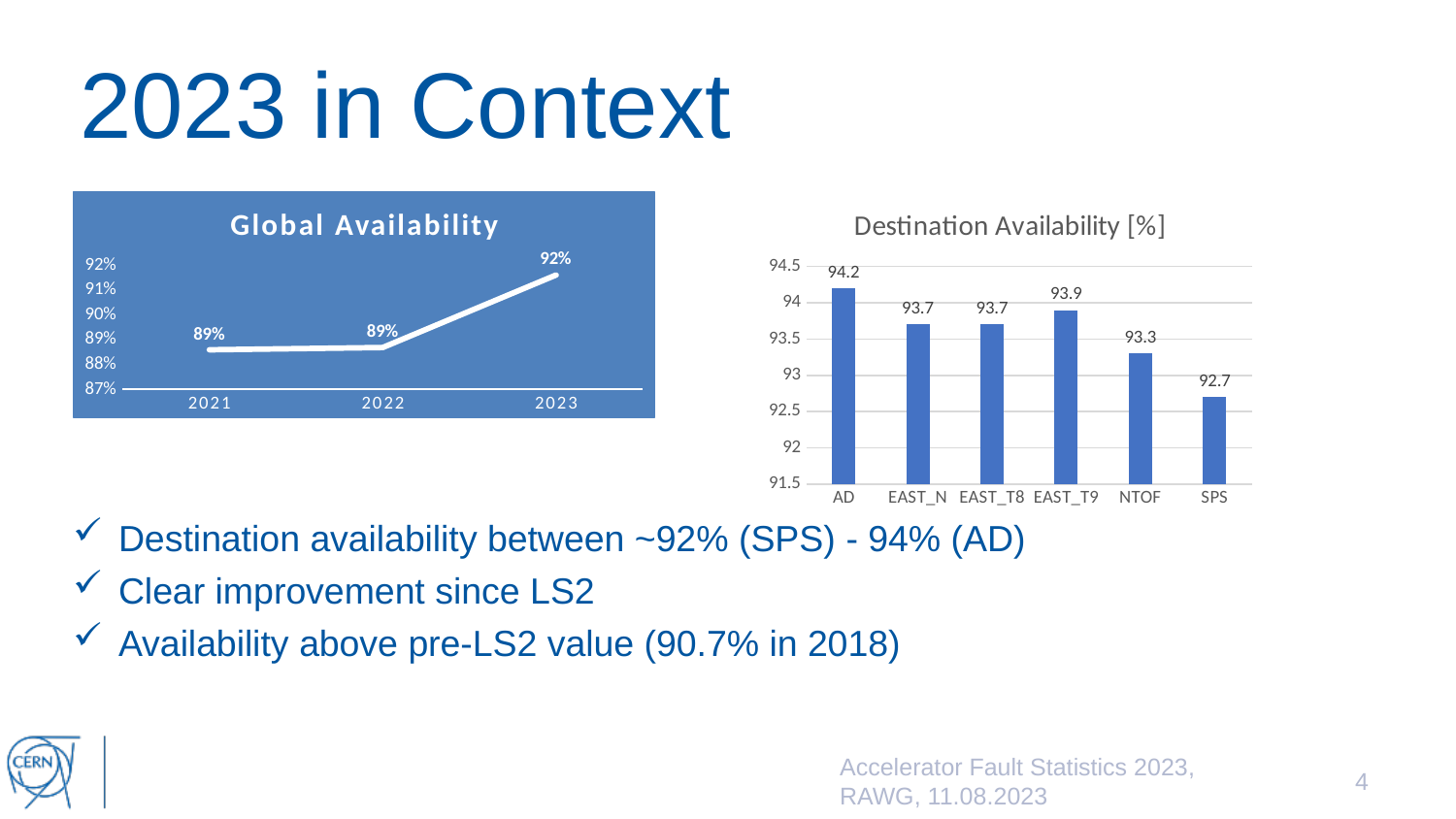
In the Destination Availability [%] chart, what is the value for EAST_T9? 93.9 What kind of chart is the Destination Availability [%] chart? bar chart What kind of chart is the Global Availability chart? line chart In the Destination Availability [%] chart, what is the value for NTOF? 93.3 In the Destination Availability [%] chart, which destination has the highest availability? AD How many years are shown on the x axis of the Global Availability chart? 3 In the Destination Availability [%] chart, which is larger, the value for EAST_T9 or the value for NTOF? EAST_T9 In the Global Availability chart, what is the value for 2023? 92% In the Destination Availability [%] chart, which destination has the lowest availability? SPS In the Destination Availability [%] chart, what is the difference between the values for AD and SPS? 1.5 In the Global Availability chart, what is the value for 2021? 89% In the Global Availability chart, do the values rise or fall from 2021 to 2023? rise